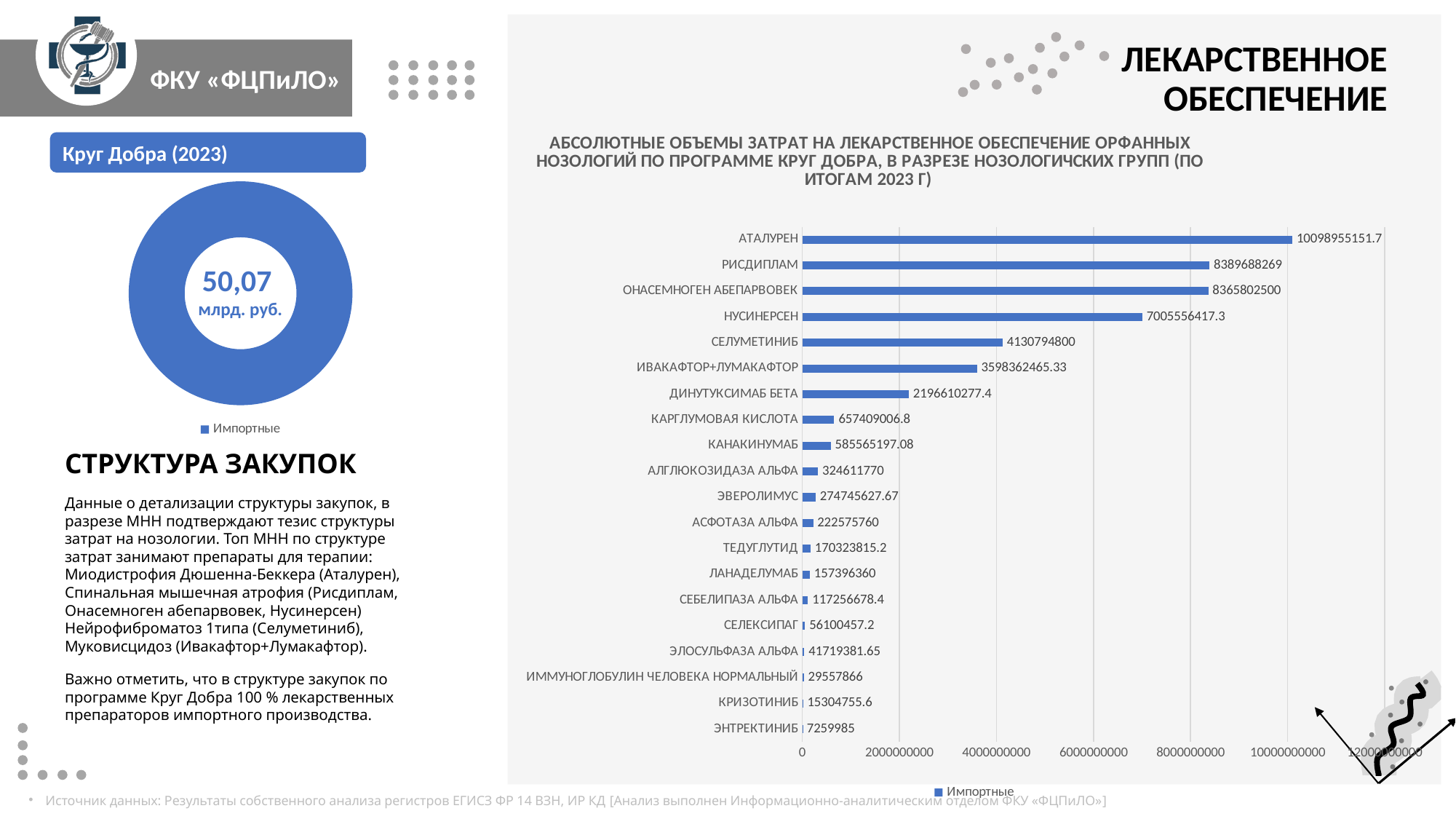
What type of chart is the chart on the right titled «АБСОЛЮТНЫЕ ОБЪЕМЫ ЗАТРАТ...»? bar chart In the bar chart on the right, which category has the lowest value? ЭНТРЕКТИНИБ In the bar chart on the right, what is the value for АТАЛУРЕН? 10098955151.7 In the bar chart on the right, is the value for ДИНУТУКСИМАБ БЕТА greater or less than 4000000000? less What value is shown in the centre of the donut chart on the left? 50,07 млрд. руб. In the bar chart on the right, what is the difference between the values for СЕЛУМЕТИНИБ and АЛГЛЮКОЗИДАЗА АЛЬФА? 3806183030 How many categories are shown in the bar chart on the right? 20 In the bar chart on the right, what is the value for ЭНТРЕКТИНИБ? 7259985 In the bar chart on the right, which category has the highest value? АТАЛУРЕН How many series does the legend of the bar chart on the right list? 1 In the bar chart on the right, which is larger: the value for НУСИНЕРСЕН or the value for СЕЛУМЕТИНИБ? НУСИНЕРСЕН In the bar chart on the right, what is the value for ИВАКАФТОР+ЛУМАКАФТОР? 3598362465.33